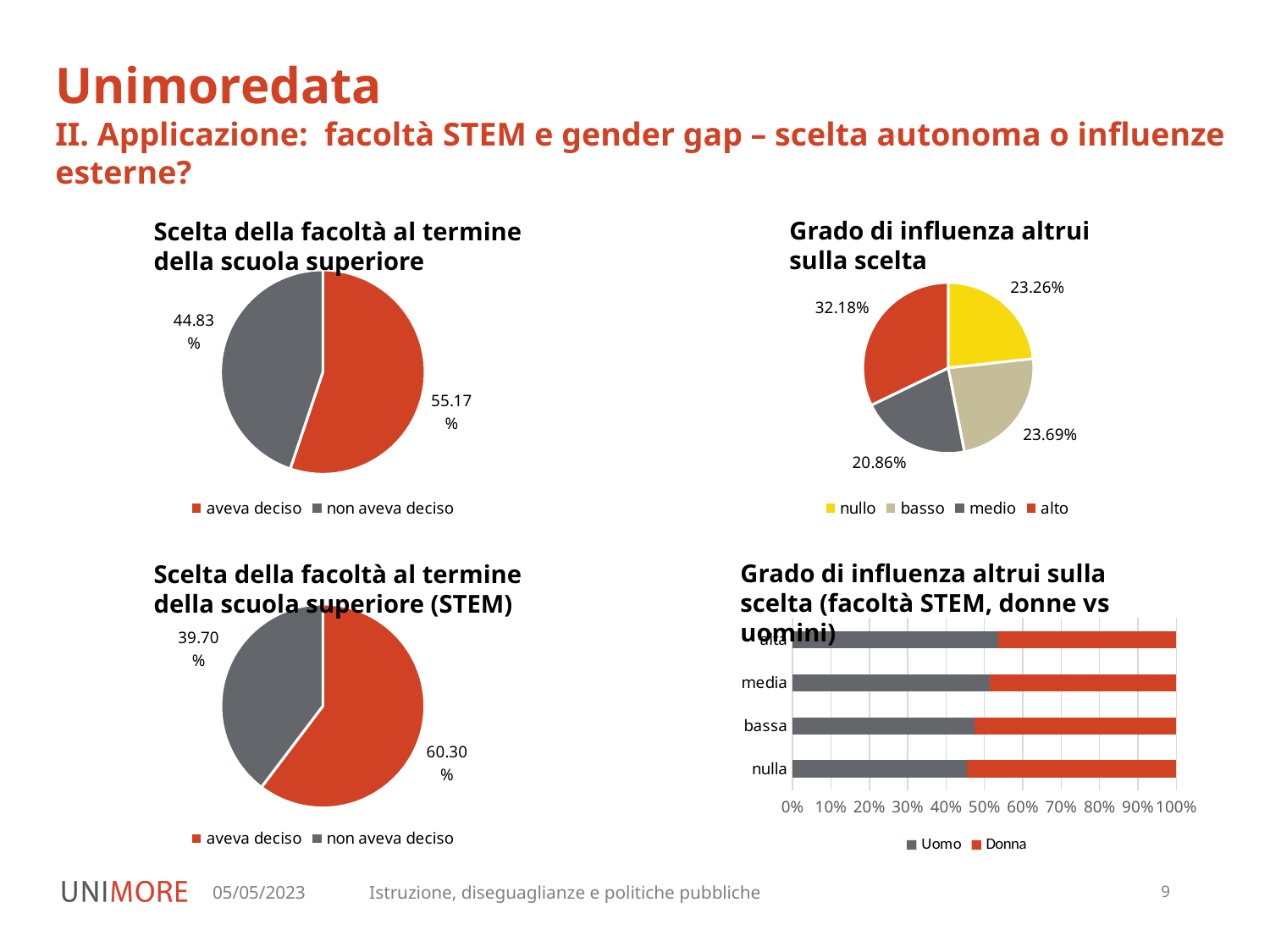
In the chart 'Scelta della facoltà al termine della scuola superiore (STEM)', what is the value for 'non aveva deciso'? 39.70% In the chart 'Grado di influenza altrui sulla scelta', which category has the lowest value? medio In the chart 'Grado di influenza altrui sulla scelta', what is the value for 'alto'? 32.18% In the chart 'Grado di influenza altrui sulla scelta', which colour represents 'nullo'? yellow In the chart 'Grado di influenza altrui sulla scelta (facoltà STEM, donne vs uomini)', is the value for 'Uomo' in the 'nulla' category greater or less than 50%? less In the chart 'Grado di influenza altrui sulla scelta', how many slices does the pie have? 4 What kind of chart is 'Grado di influenza altrui sulla scelta (facoltà STEM, donne vs uomini)'? bar chart In the chart 'Grado di influenza altrui sulla scelta', what is the difference between 'alto' and 'medio'? 11.32% In the chart 'Scelta della facoltà al termine della scuola superiore (STEM)', what is the difference between 'aveva deciso' and 'non aveva deciso'? 20.60% In the chart 'Grado di influenza altrui sulla scelta', which category has the highest value? alto In the chart 'Grado di influenza altrui sulla scelta (facoltà STEM, donne vs uomini)', how many series does the legend list? 2 In the chart 'Scelta della facoltà al termine della scuola superiore', what is the value for 'aveva deciso'? 55.17%